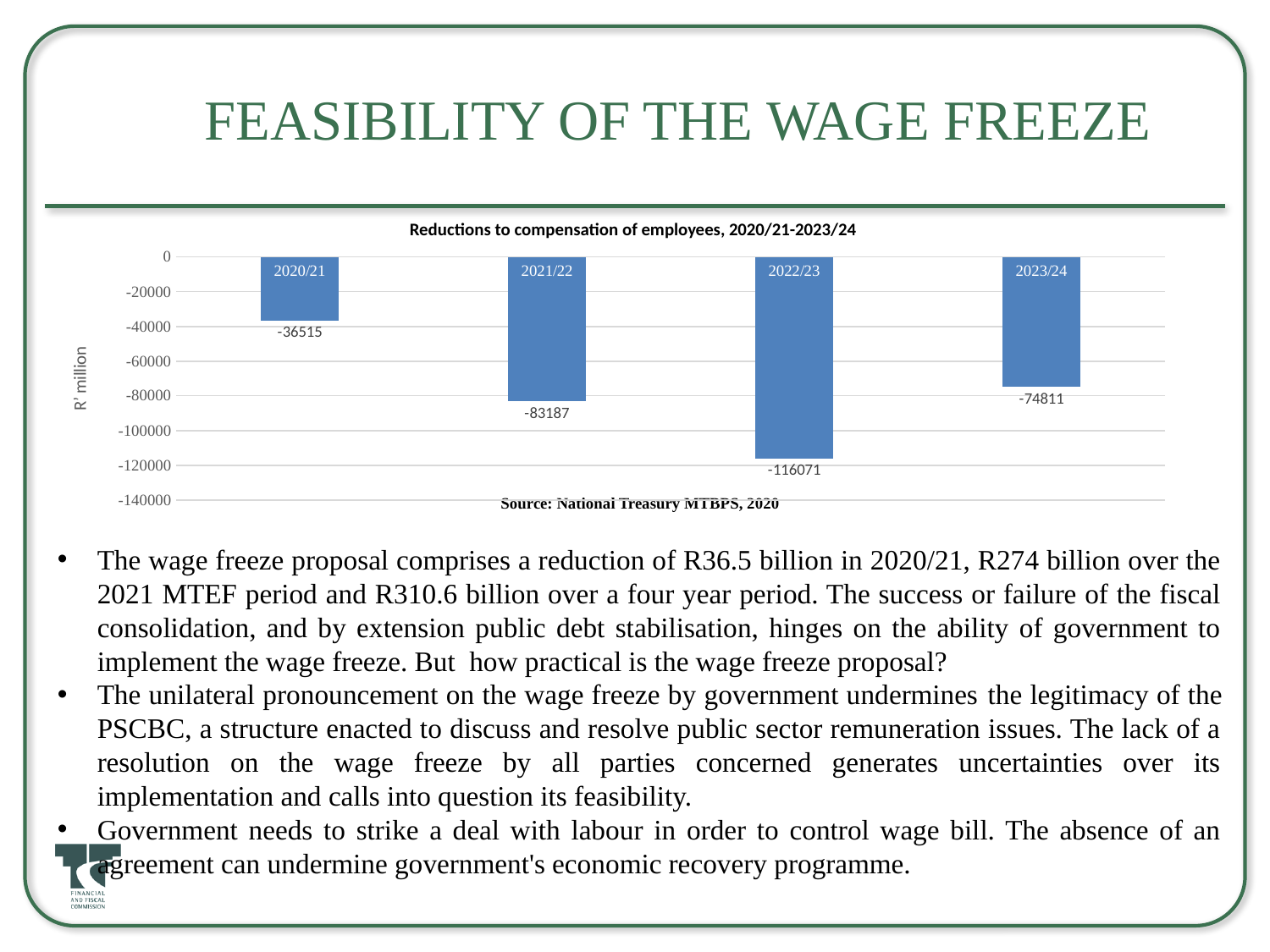
What is the difference between the values for 2022/23 and 2021/22? 32884 What is the difference between the values for 2021/22 and 2020/21? 46672 Which year has the lowest (most negative) value in the chart? 2022/23 What is the title of the chart? Reductions to compensation of employees, 2020/21-2023/24 What is the value for 2023/24 in the chart? -74811 Which year has the highest (least negative) value in the chart? 2020/21 What is the value for 2020/21 in the chart? -36515 What is the value for 2021/22 in the chart? -83187 What kind of chart is shown on the slide? Bar chart Which year shows a larger reduction, 2021/22 or 2023/24? 2021/22 How many years are shown in the chart? 4 What is the value for 2022/23 in the chart? -116071